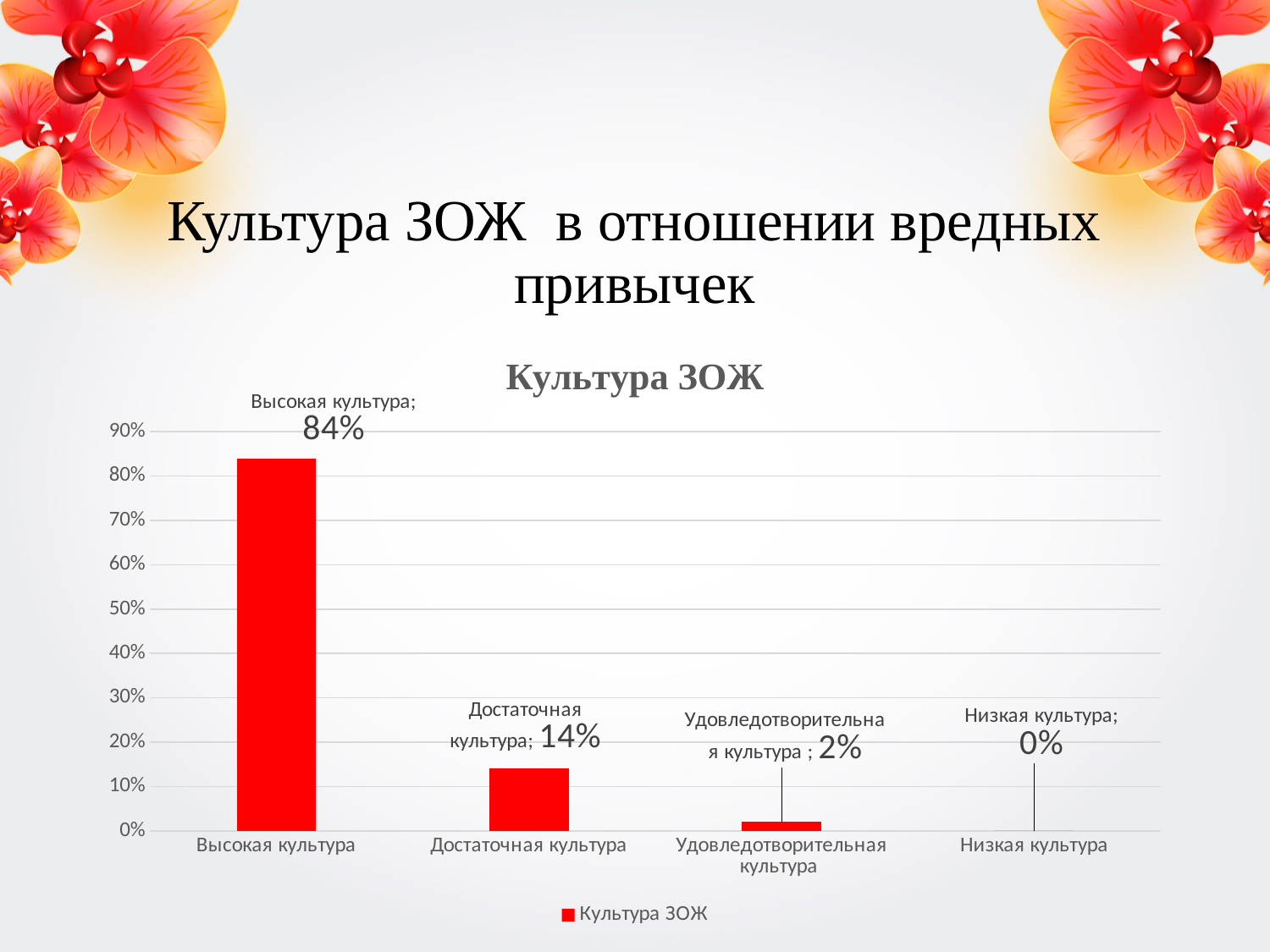
What is the value for Высокая культура? 84% What is the value for Низкая культура? 0% Is the value for Высокая культура greater or less than 80%? greater What is the value for Удовледотворительная культура? 2% How many categories are shown on the x axis? 4 Which is larger, the value for Достаточная культура or the value for Удовледотворительная культура? Достаточная культура Which category has the lowest value? Низкая культура Which category has the highest value? Высокая культура What is the value for Достаточная культура? 14% What kind of chart is shown on the slide? bar chart What is the title of the chart? Культура ЗОЖ What is the difference between the values for Высокая культура and Достаточная культура? 70%